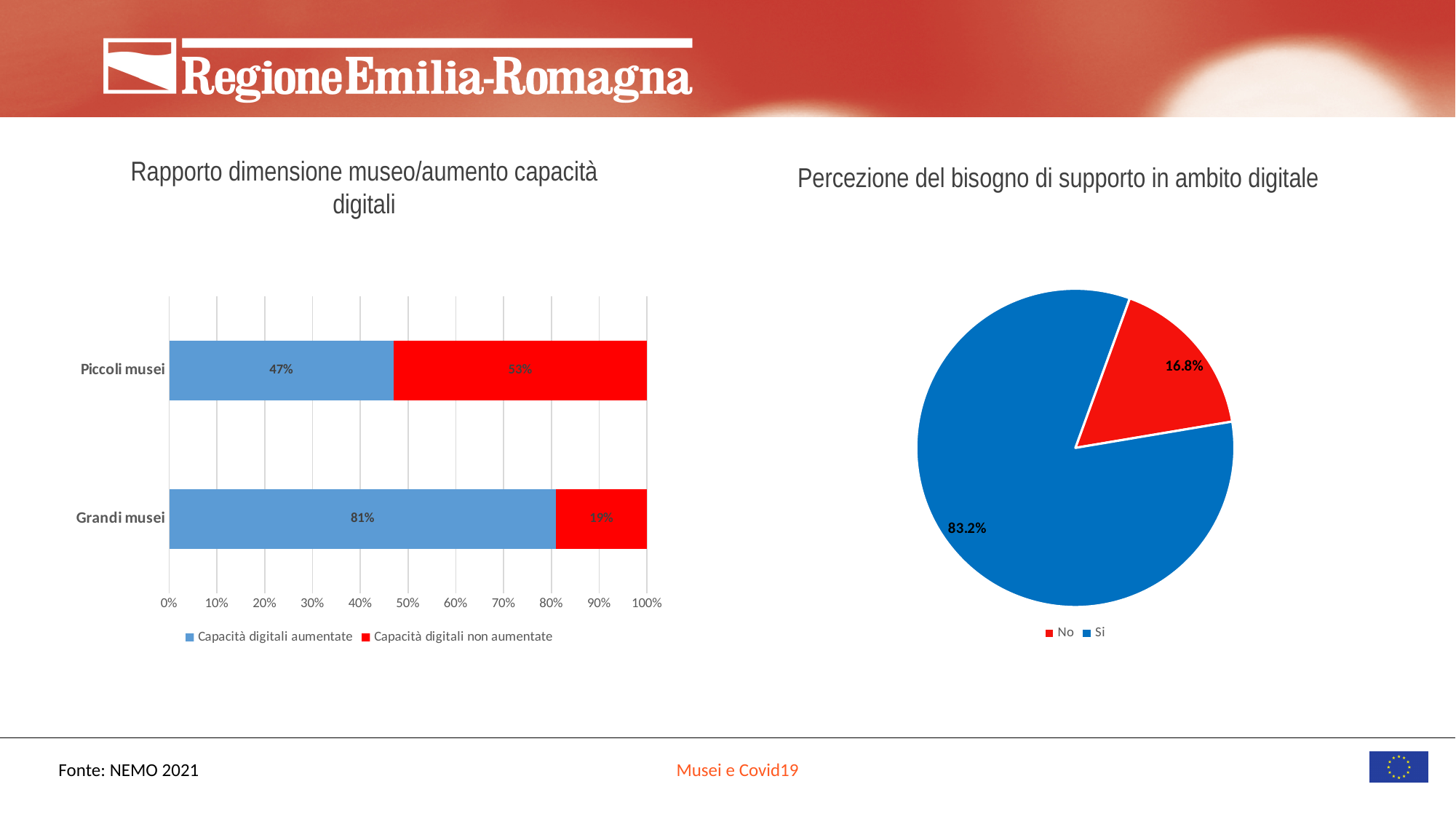
What kind of chart is 'Percezione del bisogno di supporto in ambito digitale'? Pie chart In the chart 'Rapporto dimensione museo/aumento capacità digitali', which category has the higher value for 'Capacità digitali aumentate', Piccoli musei or Grandi musei? Grandi musei In the chart 'Rapporto dimensione museo/aumento capacità digitali', what is the value of 'Capacità digitali non aumentate' for Piccoli musei? 53% In the chart 'Rapporto dimensione museo/aumento capacità digitali', how many categories are shown? 2 What kind of chart is 'Rapporto dimensione museo/aumento capacità digitali'? Stacked bar chart In the chart 'Rapporto dimensione museo/aumento capacità digitali', how many series does the legend list? 2 In the chart 'Rapporto dimensione museo/aumento capacità digitali', what is the value of 'Capacità digitali aumentate' for Piccoli musei? 47% In the chart 'Percezione del bisogno di supporto in ambito digitale', what share of the pie is 'Si'? 83.2% In the chart 'Percezione del bisogno di supporto in ambito digitale', what is the value for 'No'? 16.8% In the chart 'Rapporto dimensione museo/aumento capacità digitali', what is the difference between the 'Capacità digitali aumentate' values for Grandi musei and Piccoli musei? 34% In the chart 'Rapporto dimensione museo/aumento capacità digitali', what is the value of 'Capacità digitali aumentate' for Grandi musei? 81% In the chart 'Percezione del bisogno di supporto in ambito digitale', which slice is the largest? Si